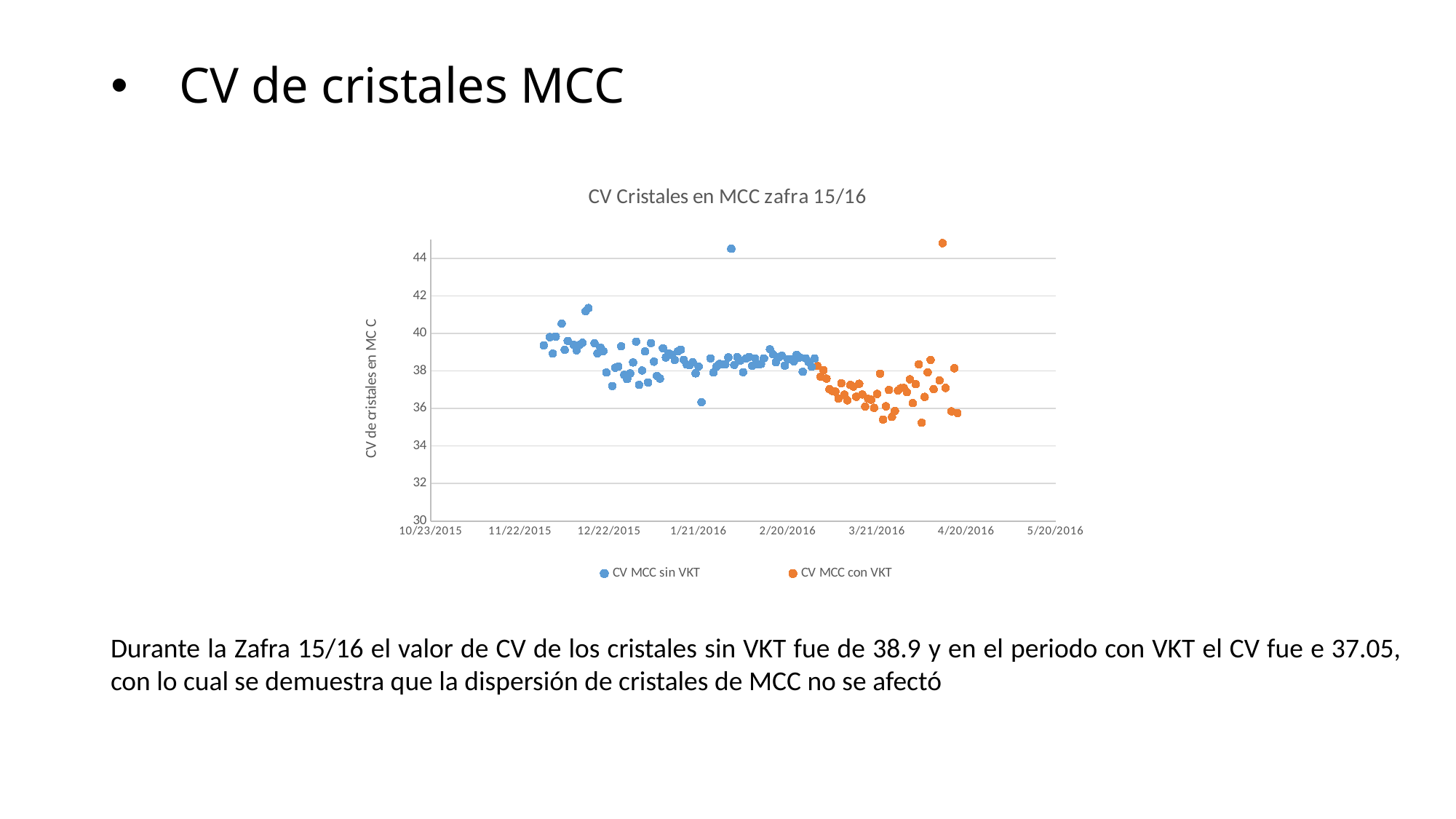
Do the CV values generally rise or fall from the start of the CV MCC sin VKT series to the end of the CV MCC con VKT series? fall Which series appears later in time along the x axis? CV MCC con VKT What are the two series named in the chart legend? CV MCC sin VKT and CV MCC con VKT Is the lowest point of the CV MCC con VKT series greater or less than 36? less How many series does the chart legend list? 2 Which series has most of its points plotted below 38? CV MCC con VKT What kind of chart is shown on the slide? Scatter chart Is the lowest point of the CV MCC sin VKT series greater or less than 38? less Is the highest point of the CV MCC con VKT series greater or less than 44? greater What is the title of the chart? CV Cristales en MCC zafra 15/16 What is the lowest value shown on the y axis? 30